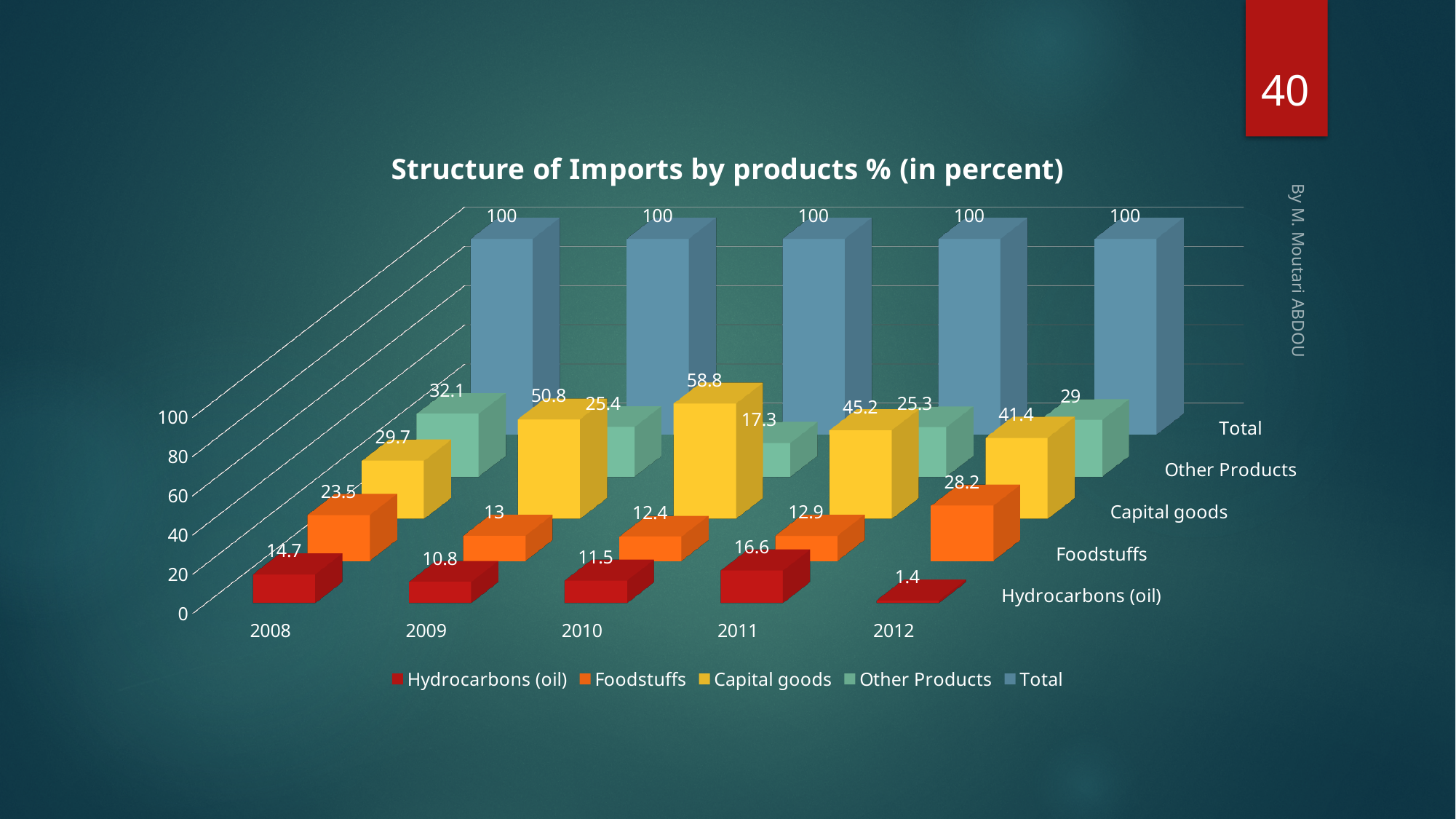
How many series does the legend list? 5 How many years are shown on the x axis? 5 In which year is the Capital goods value highest? 2010 In which year is the Hydrocarbons (oil) value lowest? 2012 What is the value for Foodstuffs in 2012? 28.2 What kind of chart is shown on the slide? Bar chart What is the title of the chart? Structure of Imports by products % (in percent) What is the difference between the Capital goods values for 2010 and 2008? 29.1 What is the value for Other Products in 2008? 32.1 What is the value for Capital goods in 2010? 58.8 Which is larger, Foodstuffs in 2008 or Foodstuffs in 2009? Foodstuffs in 2008 What is the value for Hydrocarbons (oil) in 2012? 1.4